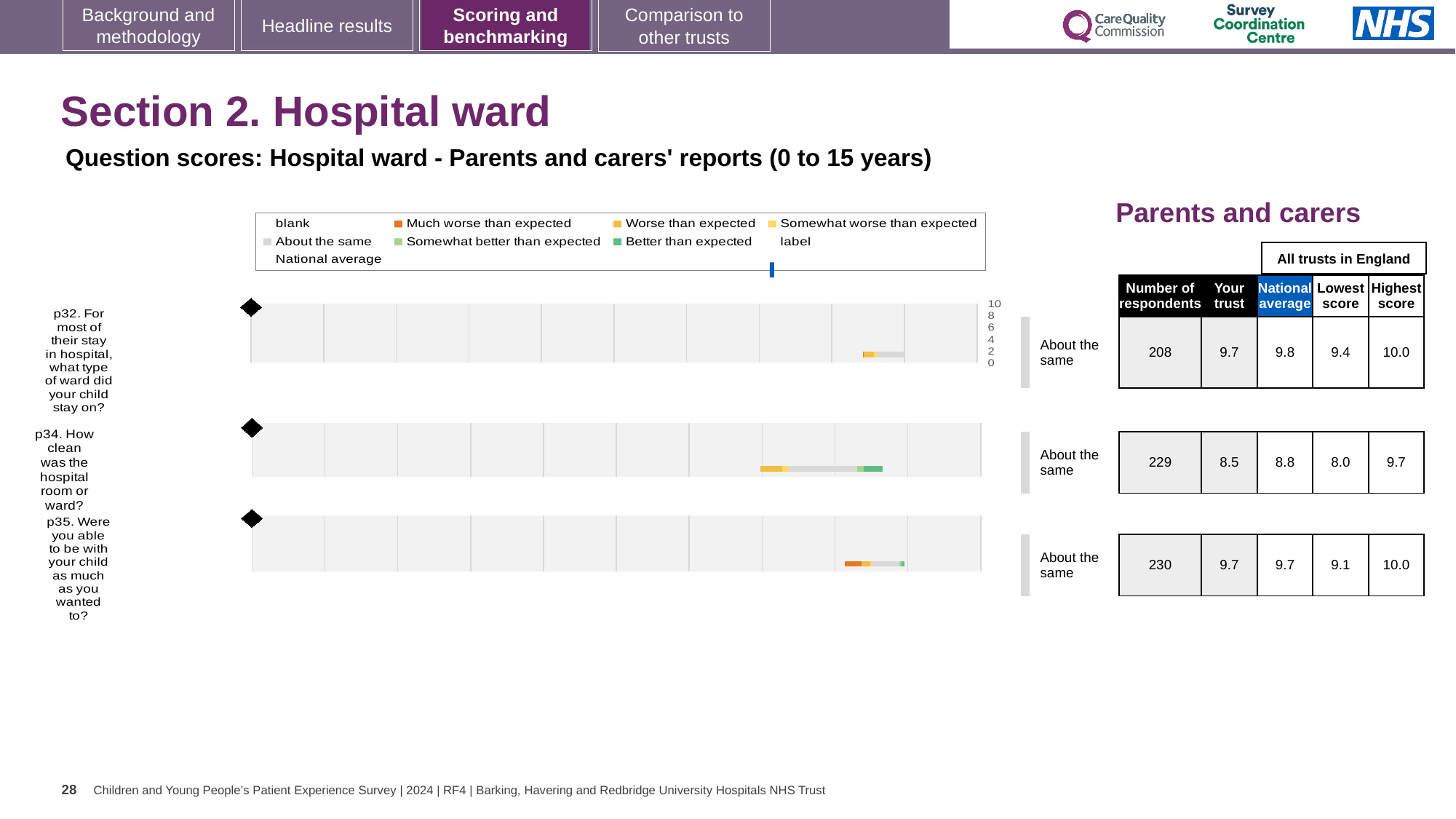
Which question has the fewest respondents? p32. For most of their stay in hospital, what type of ward did your child stay on? How many respondents answered p35 (Were you able to be with your child as much as you wanted to?)? 230 What kind of chart is used to show the question scores on this slide? bar chart For p34, which is larger: the trust's score or the national average? National average Is the 'Your trust' score for p34 greater or less than 8? greater What benchmark category is shown for all three questions on this slide? About the same Which question has the lowest 'Your trust' score? p34. How clean was the hospital room or ward? What is the difference between the highest and lowest scores in England for p34? 1.7 How many survey questions are plotted on the slide? 3 What is the 'Your trust' score for p34 (How clean was the hospital room or ward?)? 8.5 What is the national average score for p32 (what type of ward did your child stay on)? 9.8 What is the lowest score among all trusts in England for p34? 8.0